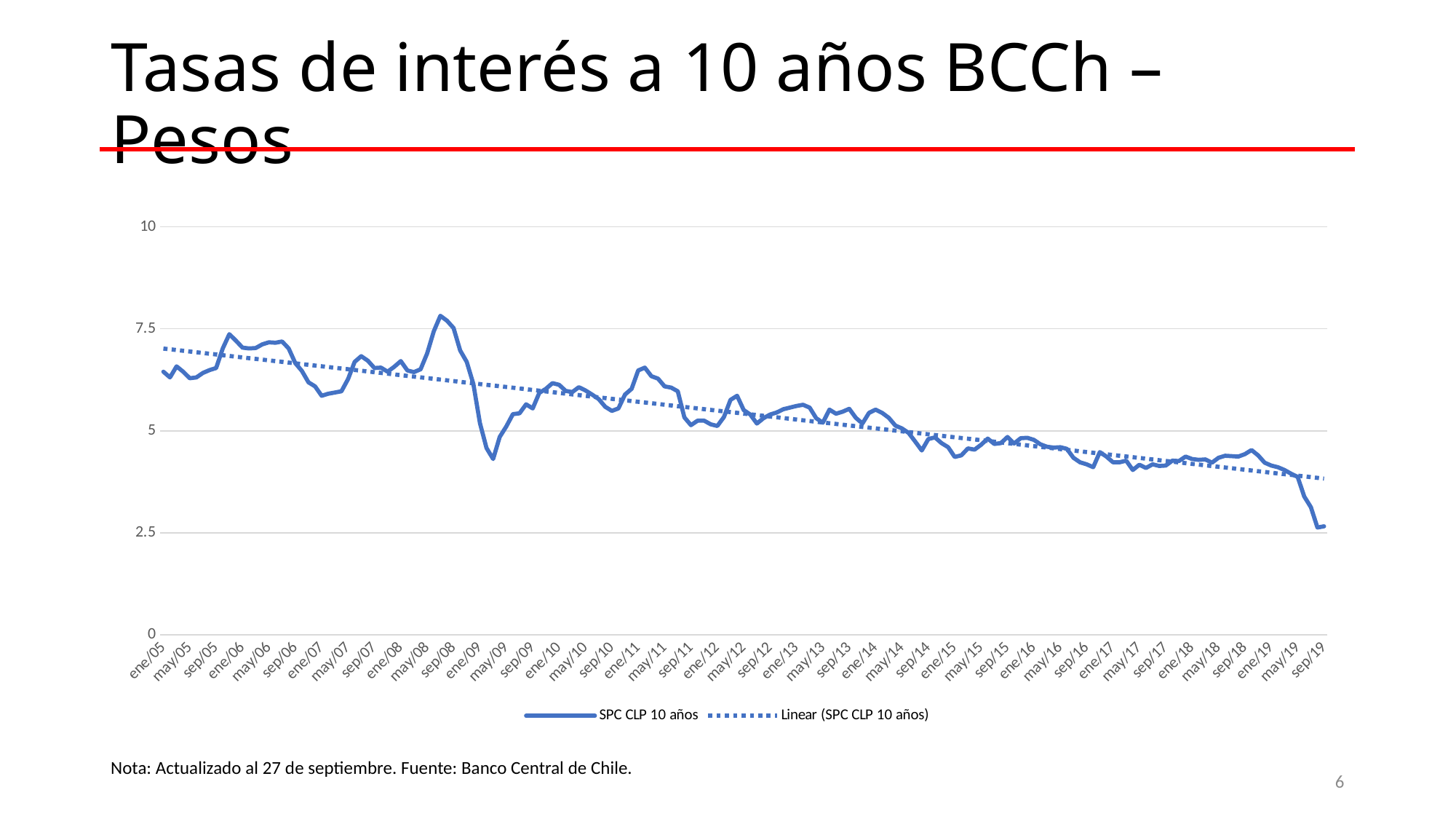
What is the highest value shown on the vertical axis? 10 Is the SPC CLP 10 años value at ene/06 greater or less than 5? greater Which is larger, the SPC CLP 10 años value at ene/05 or at sep/19? ene/05 What kind of chart is shown on the slide? Line chart Overall, do the SPC CLP 10 años values rise or fall from ene/05 to sep/19? Fall What are the two entries in the chart legend? SPC CLP 10 años and Linear (SPC CLP 10 años) How many series does the legend list? 2 Is the SPC CLP 10 años value at ene/05 greater or less than 7.5? less Is the SPC CLP 10 años value at sep/19 greater or less than 5? less